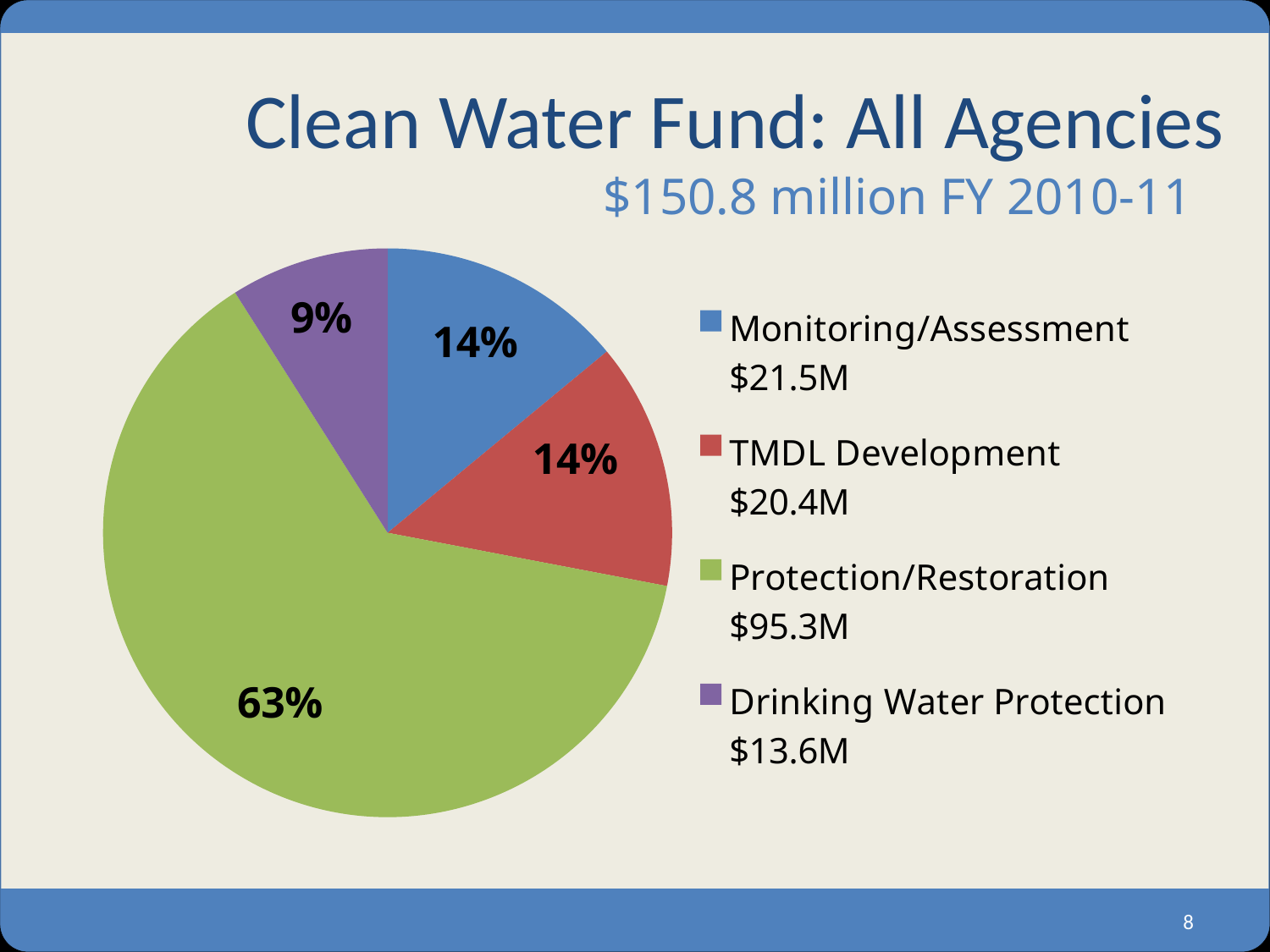
Which is larger in dollar terms, Monitoring/Assessment or TMDL Development? Monitoring/Assessment Which category has the largest slice of the pie? Protection/Restoration What kind of chart is shown on the slide? pie chart What colour is the Protection/Restoration slice? green What share of the pie does Protection/Restoration represent? 63% How many categories does the legend list? 4 What is the dollar amount shown in the legend for Protection/Restoration? $95.3M What share of the pie does Drinking Water Protection represent? 9% What share of the pie does Monitoring/Assessment represent? 14% What is the dollar amount shown in the legend for TMDL Development? $20.4M Which category has the smallest slice of the pie? Drinking Water Protection What is the dollar amount shown in the legend for Drinking Water Protection? $13.6M